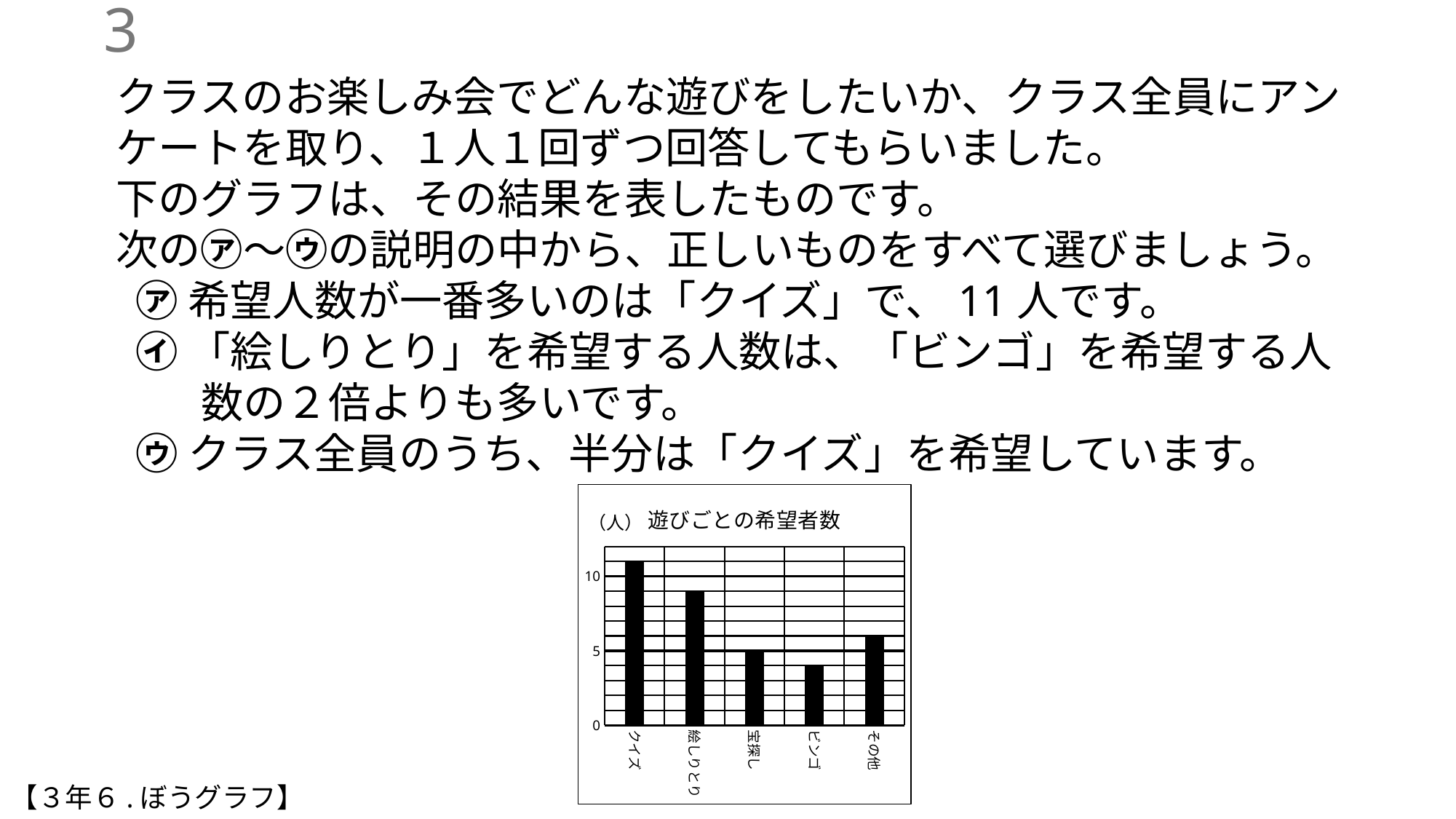
Which category has the highest value in the chart? クイズ What is the value for 宝探し in the chart? 5 What unit is shown next to the vertical axis of the chart? （人） Is the value for クイズ greater or less than 10? greater What kind of chart is shown on the slide? bar chart Which is larger, the value for 絵しりとり or the value for その他? 絵しりとり Is the value for ビンゴ greater or less than 5? less How many categories are shown on the x axis of the chart? 5 Is the value for 絵しりとり greater or less than 10? less Which category has the lowest value in the chart? ビンゴ What is the title of the chart? 遊びごとの希望者数